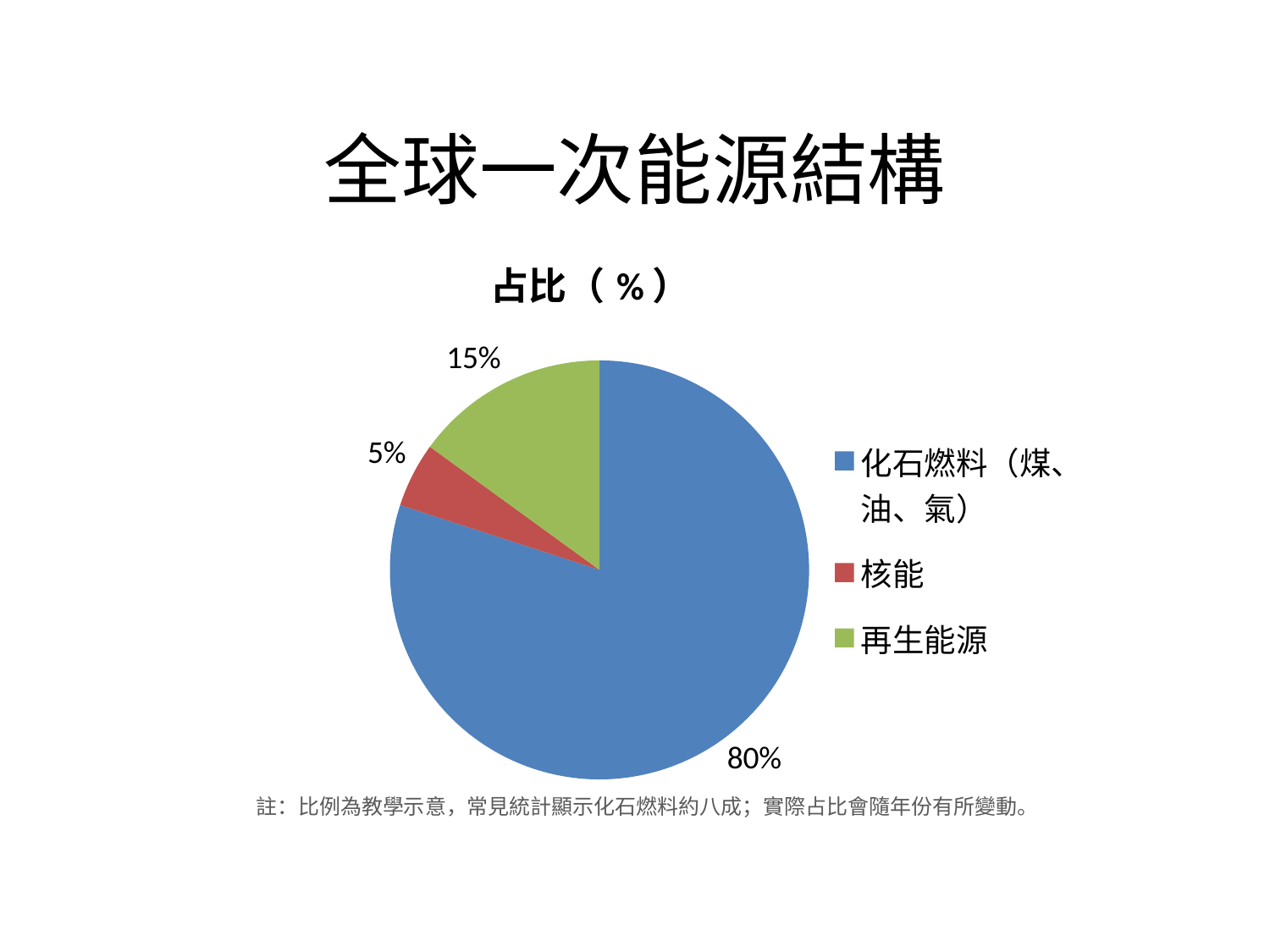
How many categories does the pie chart show? 3 What is the share for 化石燃料（煤、油、氣）? 80% What type of chart is shown on the slide? pie chart What is the title of the chart? 占比（%） Which category has the smallest slice of the pie? 核能 What is the difference in percentage points between 再生能源 and 核能? 10 What is the difference in percentage points between 化石燃料（煤、油、氣） and 再生能源? 65 What is the share for 再生能源? 15% What is the share for 核能? 5% Which category has the largest slice of the pie? 化石燃料（煤、油、氣） What colour is the slice for 再生能源? green Which is larger, the share for 再生能源 or the share for 核能? 再生能源